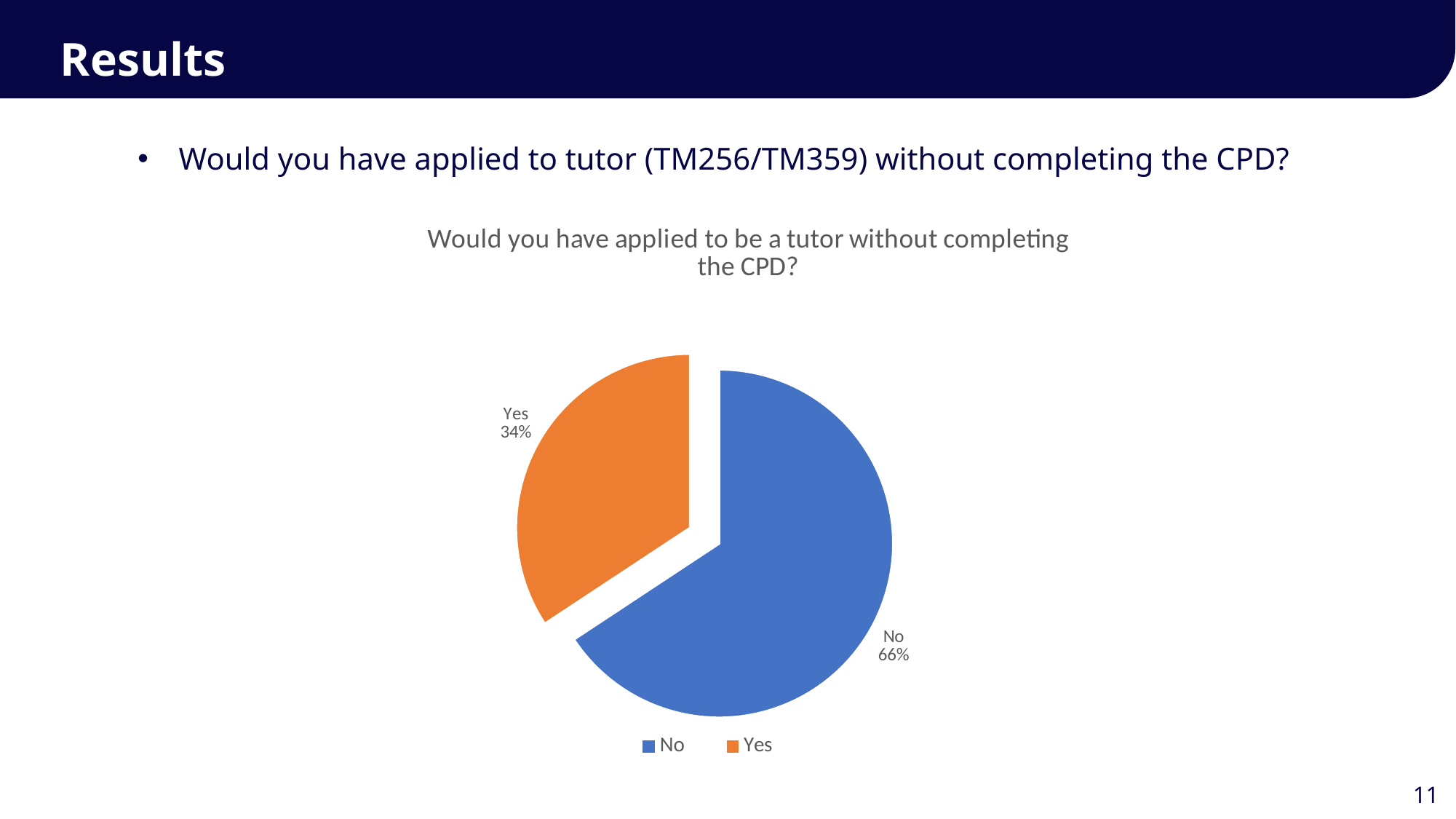
What percentage of respondents answered "No"? 66% What percentage of respondents answered "Yes"? 34% What kind of chart is shown on the slide? Pie chart How many slices does the pie chart have? 2 Which response has the largest share of the pie? No How many entries does the legend list? 2 What is the title of the chart? Would you have applied to be a tutor without completing the CPD? What colour is the "Yes" slice? Orange Which is larger, the share for "Yes" or the share for "No"? No Which response has the smallest share of the pie? Yes What share of the pie does the "Yes" slice represent? 34% What is the difference in percentage points between the "No" and "Yes" shares? 32